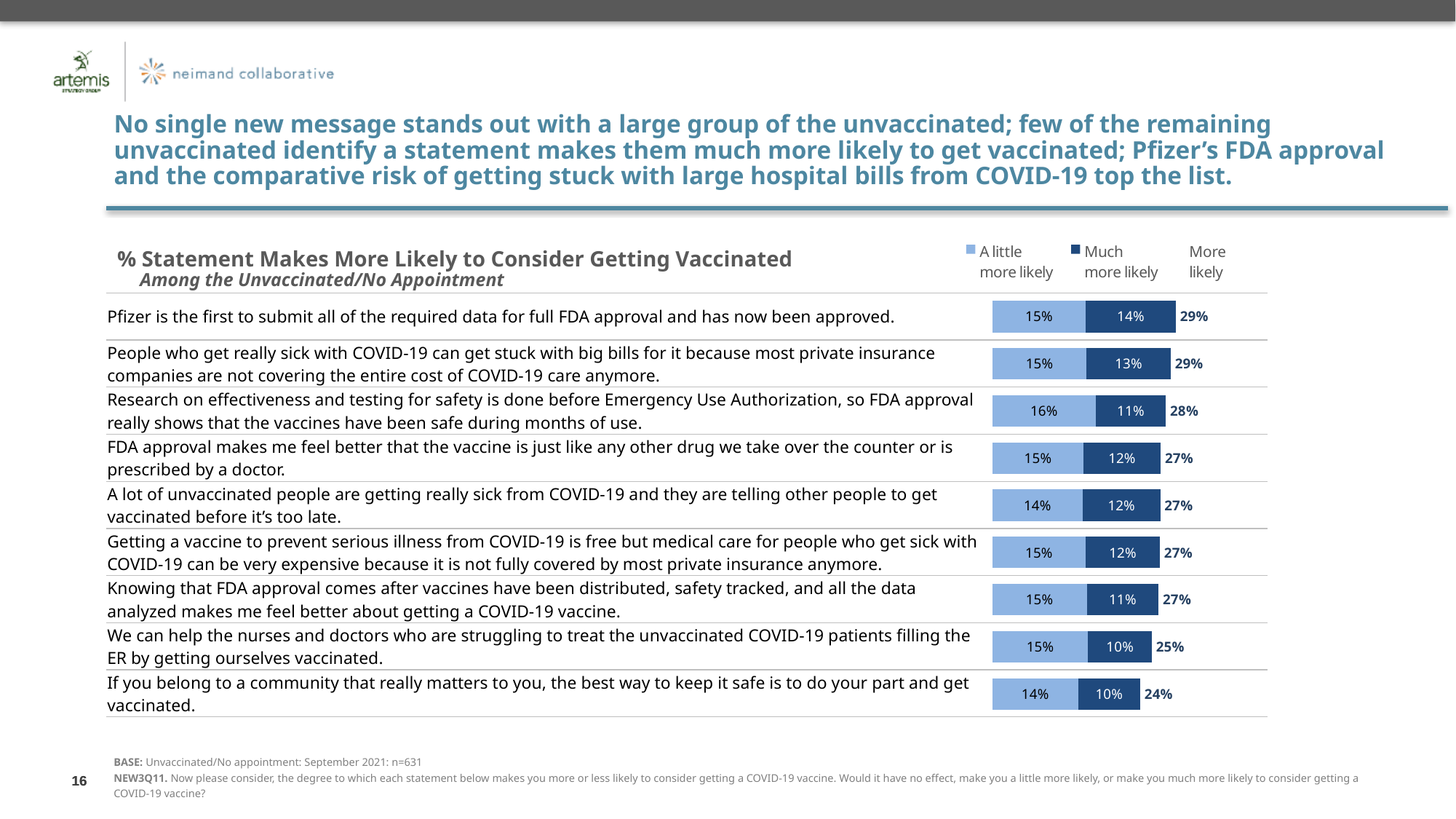
What is the 'Much more likely' value for the statement 'Pfizer is the first to submit all of the required data for full FDA approval and has now been approved'? 14% Which statement has the highest 'Much more likely' value? Pfizer is the first to submit all of the required data for full FDA approval and has now been approved. Which has a larger 'Much more likely' value: the statement about people getting stuck with big bills for COVID-19 care, or the statement about helping nurses and doctors in the ER? The statement about people getting stuck with big bills How many series with colour markers does the legend list? 2 What is the total 'More likely' value for the statement beginning 'We can help the nurses and doctors who are struggling to treat the unvaccinated COVID-19 patients'? 25% What is the total of the stacked bar for the statement beginning 'FDA approval makes me feel better that the vaccine is just like any other drug'? 27% What is the difference between the 'Much more likely' values for the Pfizer FDA approval statement (14%) and the community statement (10%)? 4 percentage points What type of chart is shown on the slide? Stacked bar chart What is the 'A little more likely' value for the statement beginning 'Research on effectiveness and testing for safety is done before Emergency Use Authorization'? 16% What is the title of the chart? % Statement Makes More Likely to Consider Getting Vaccinated Which statement has the lowest total 'More likely' value? If you belong to a community that really matters to you, the best way to keep it safe is to do your part and get vaccinated. How many statements are plotted in the chart? 9